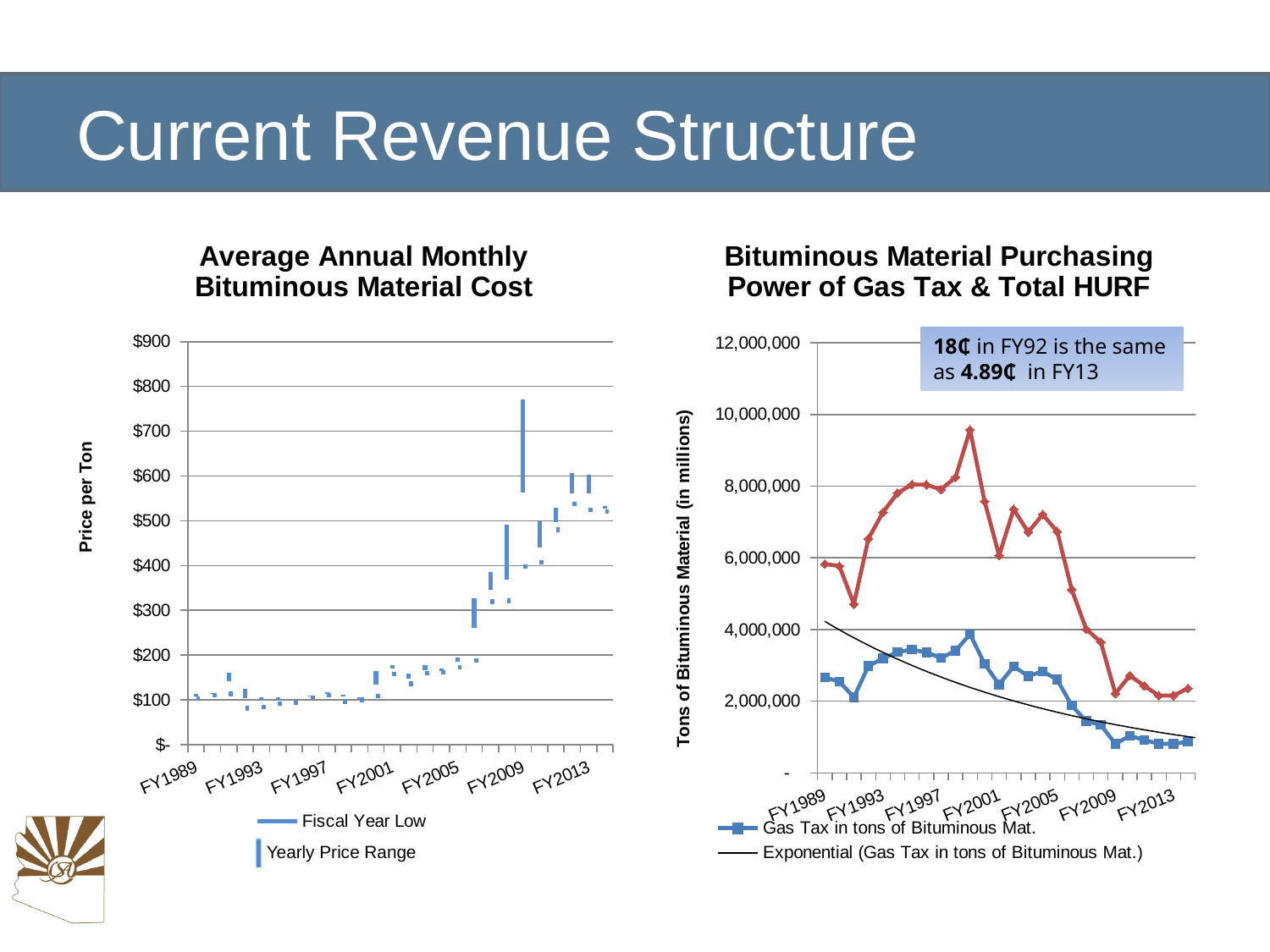
On the right chart, in which fiscal year does the red line reach its highest value? FY1999 On the right chart, how many series does the legend list? 2 On the left chart 'Average Annual Monthly Bituminous Material Cost', what is the y-axis title? Price per Ton On the right chart, does the 'Gas Tax in tons of Bituminous Mat.' series rise or fall from FY2005 to FY2013? fall On the left chart, in which fiscal year is the 'Yearly Price Range' bar tallest? FY2009 On the right chart, is the value of the red line in FY2001 greater or less than 8,000,000? less On the right chart, which is larger in FY2001: the red line or the 'Gas Tax in tons of Bituminous Mat.' line? the red line On the right chart, what does the callout box say 18¢ in FY92 is the same as? 4.89¢ in FY13 On the left chart, is the 'Fiscal Year Low' value in FY1989 greater or less than $200? less On the left chart, is the 'Fiscal Year Low' value in FY2013 greater or less than $400? greater What kind of chart is the 'Bituminous Material Purchasing Power of Gas Tax & Total HURF' chart on the right? line chart